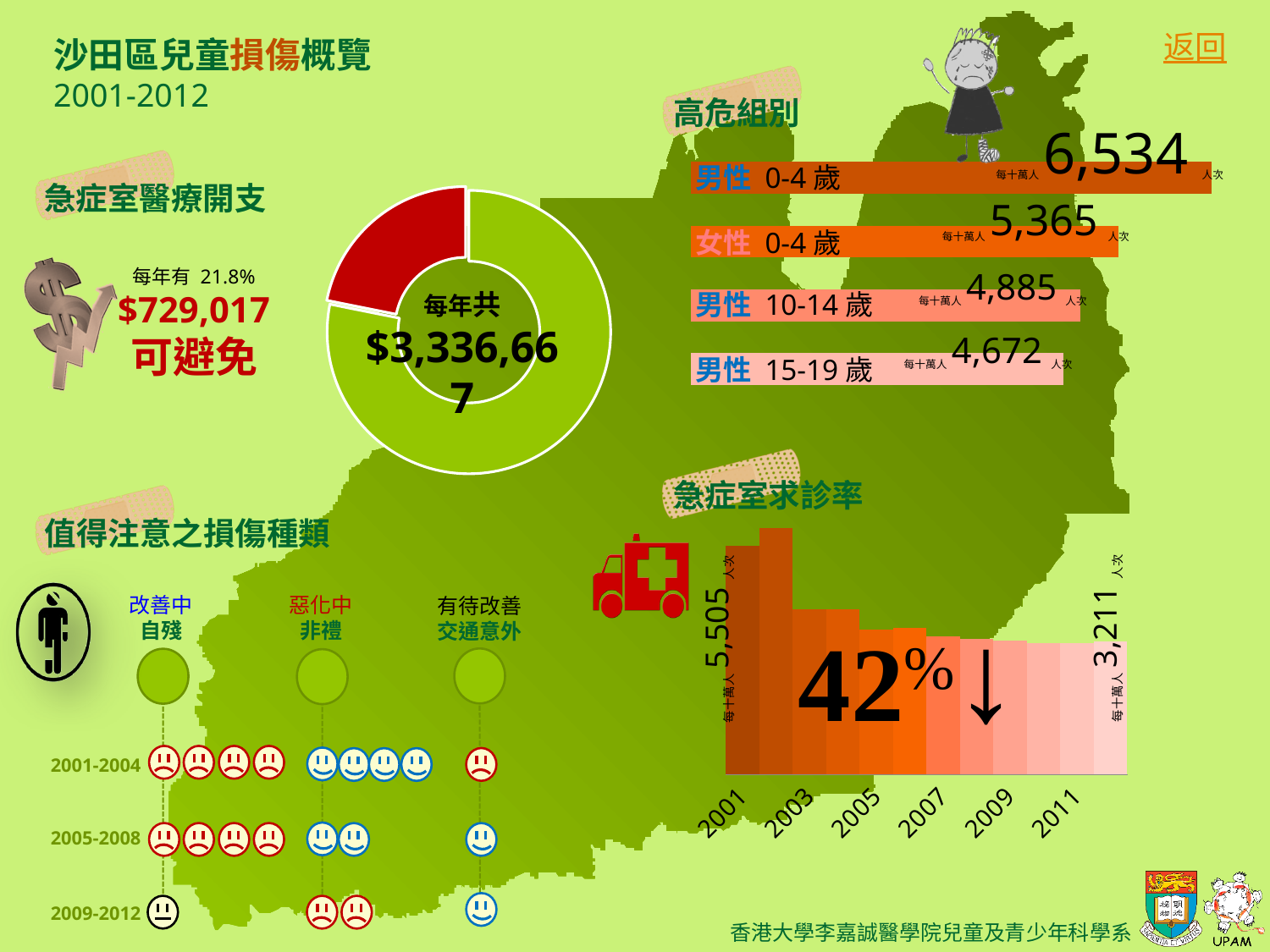
In the 高危組別 chart, what is the difference between 男性 0-4 歲 and 女性 0-4 歲? 1,169 In the 高危組別 chart, how many groups are shown? 4 In the 高危組別 chart, what is the value for 女性 0-4 歲? 5,365 In the 急症室醫療開支 donut chart, what share of the annual cost is marked as avoidable (可避免)? 21.8% What kind of chart is the 高危組別 chart? Bar chart In the 高危組別 chart, what is the value for 男性 0-4 歲? 6,534 In the 高危組別 chart, which group has the lowest value? 男性 15-19 歲 In the 急症室醫療開支 donut chart, what is the avoidable amount per year? $729,017 What kind of chart is used for 急症室醫療開支? Donut (pie) chart In the 急症室求診率 chart, what is the value for 2001? 5,505 In the 急症室醫療開支 donut chart, what is the total annual amount shown in the centre? $3,336,667 In the 急症室求診率 chart, do the values rise or fall from 2001 to 2012? Fall